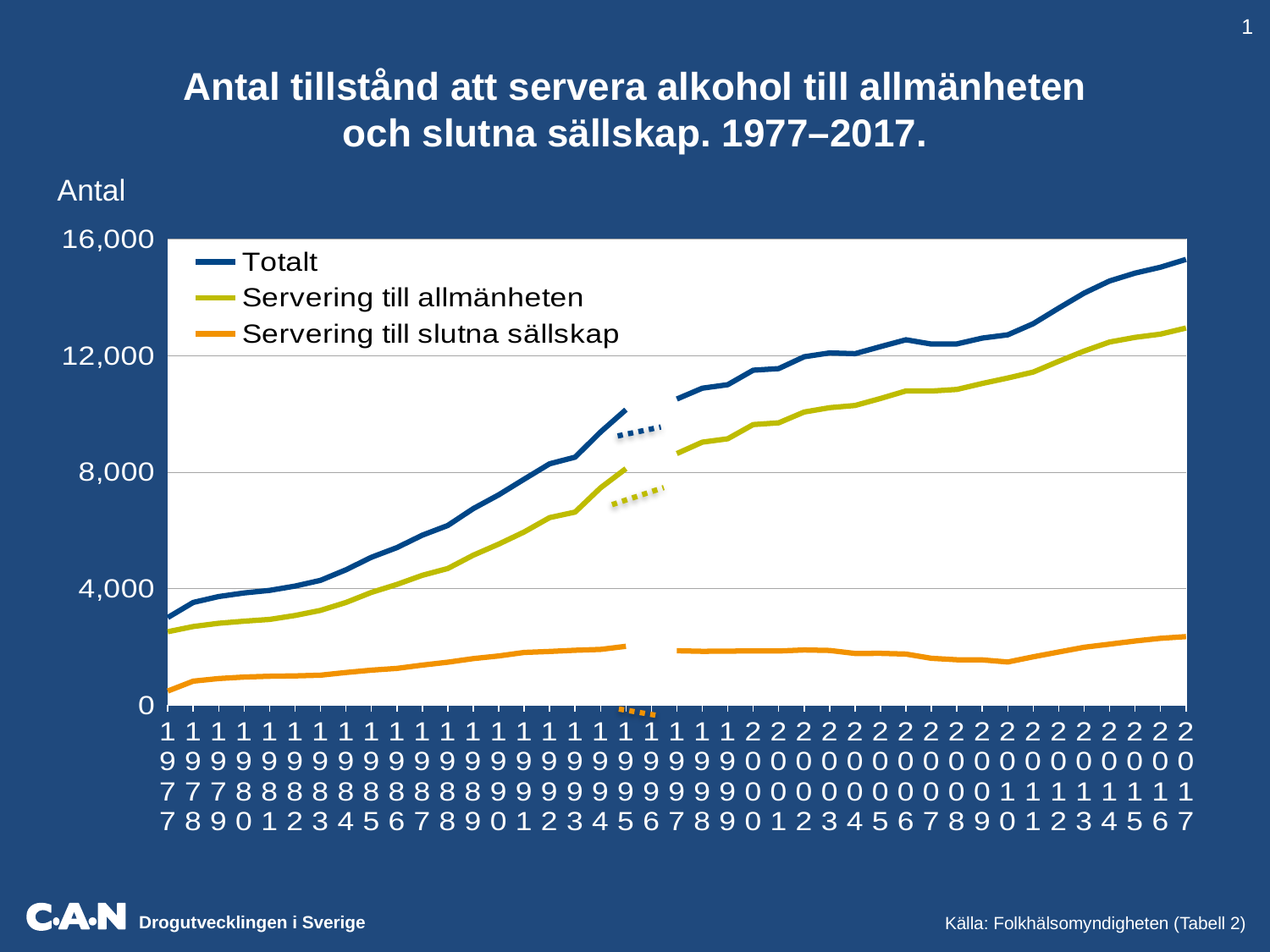
Which series has the lowest values throughout the chart? Servering till slutna sällskap Is the value for Totalt in 2017 greater or less than 12,000? greater What is the title of the chart? Antal tillstånd att servera alkohol till allmänheten och slutna sällskap. 1977–2017. In 2017, which is larger: Servering till allmänheten or Servering till slutna sällskap? Servering till allmänheten Is the value for Servering till allmänheten in 2017 greater or less than 12,000? greater What label is shown on the vertical axis? Antal What kind of chart is shown on the slide? Line chart Is the value for Servering till slutna sällskap in 2017 greater or less than 4,000? less Which series has the highest values throughout the chart? Totalt Does the Totalt series rise or fall from 1977 to 2017? Rises How many series does the legend list? 3